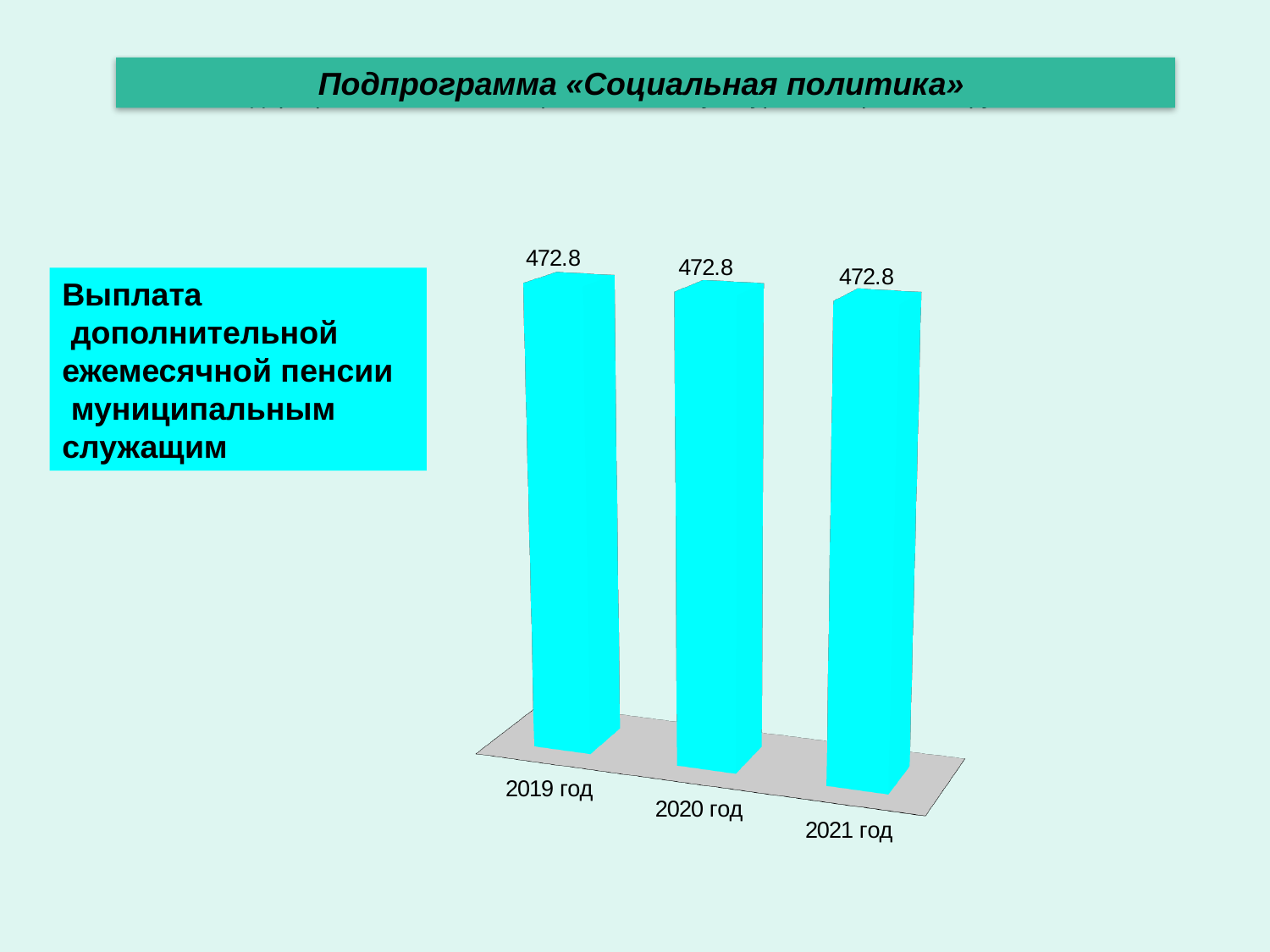
What colour are the bars on the chart? cyan What kind of chart is shown on the slide? bar chart What is the total of the values for 2019 год, 2020 год and 2021 год? 1418.4 How many categories are shown on the chart? 3 What is the difference between the values for 2019 год and 2021 год? 0 What is the value for 2019 год? 472.8 Which year is the first category on the x axis? 2019 год What is the value for 2020 год? 472.8 Do the values rise, fall or stay the same from 2019 год to 2021 год? stay the same What is the value for 2021 год? 472.8